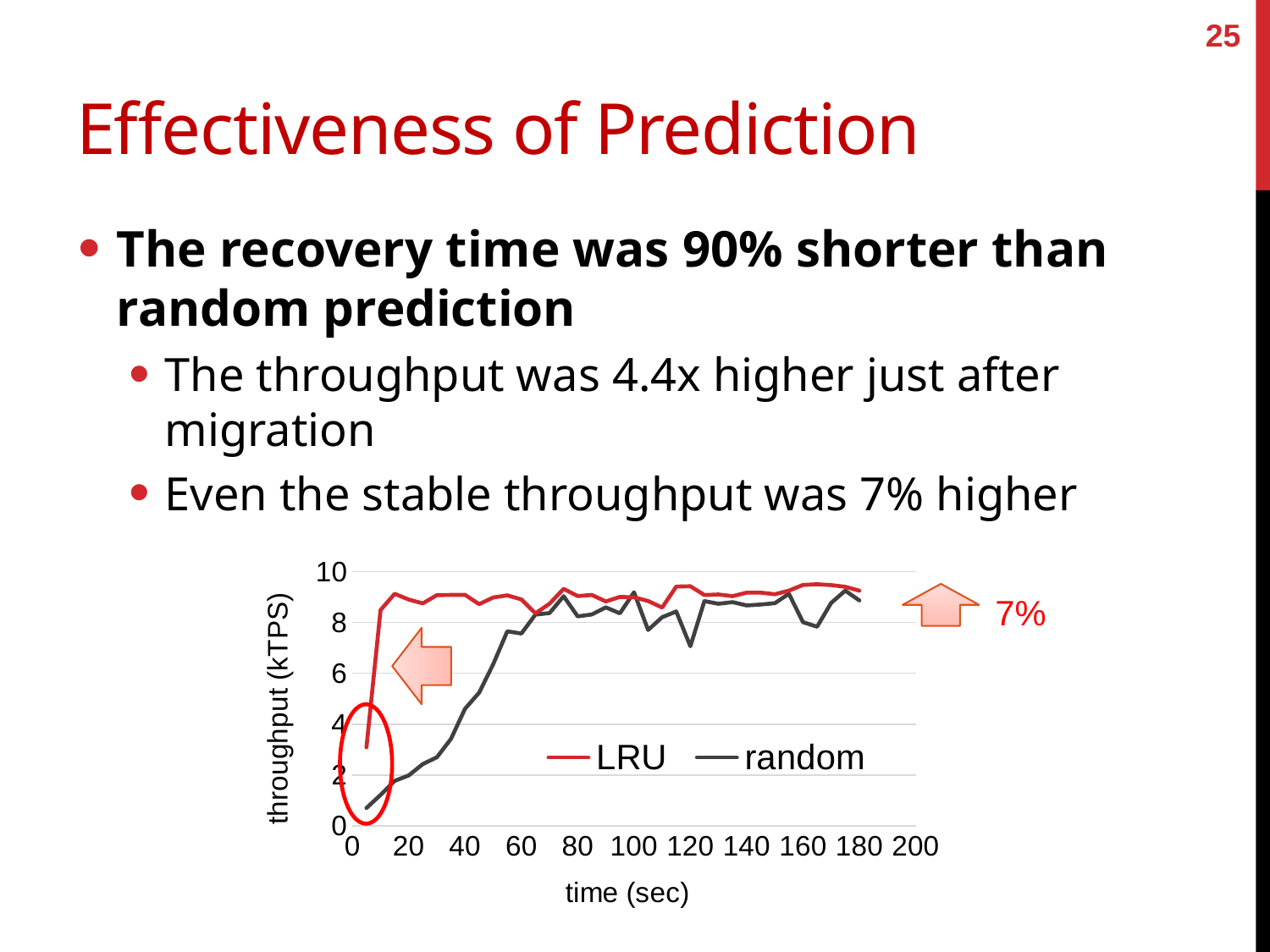
At 20 seconds, which series has the higher throughput, LRU or random? LRU Does the throughput of the random series rise or fall between 0 and 60 seconds? rise Is the throughput of random at 120 seconds greater or less than 8 kTPS? less What is the label of the chart's y axis? throughput (kTPS) What kind of chart is shown on the slide? line chart What is the highest value shown on the chart's y axis? 10 Is the throughput of random at 40 seconds greater or less than 6 kTPS? less At 120 seconds, which series has the higher throughput, LRU or random? LRU Is the throughput of LRU at 20 seconds greater or less than 8 kTPS? greater How many series does the chart's legend list? 2 What are the two series named in the chart's legend? LRU and random